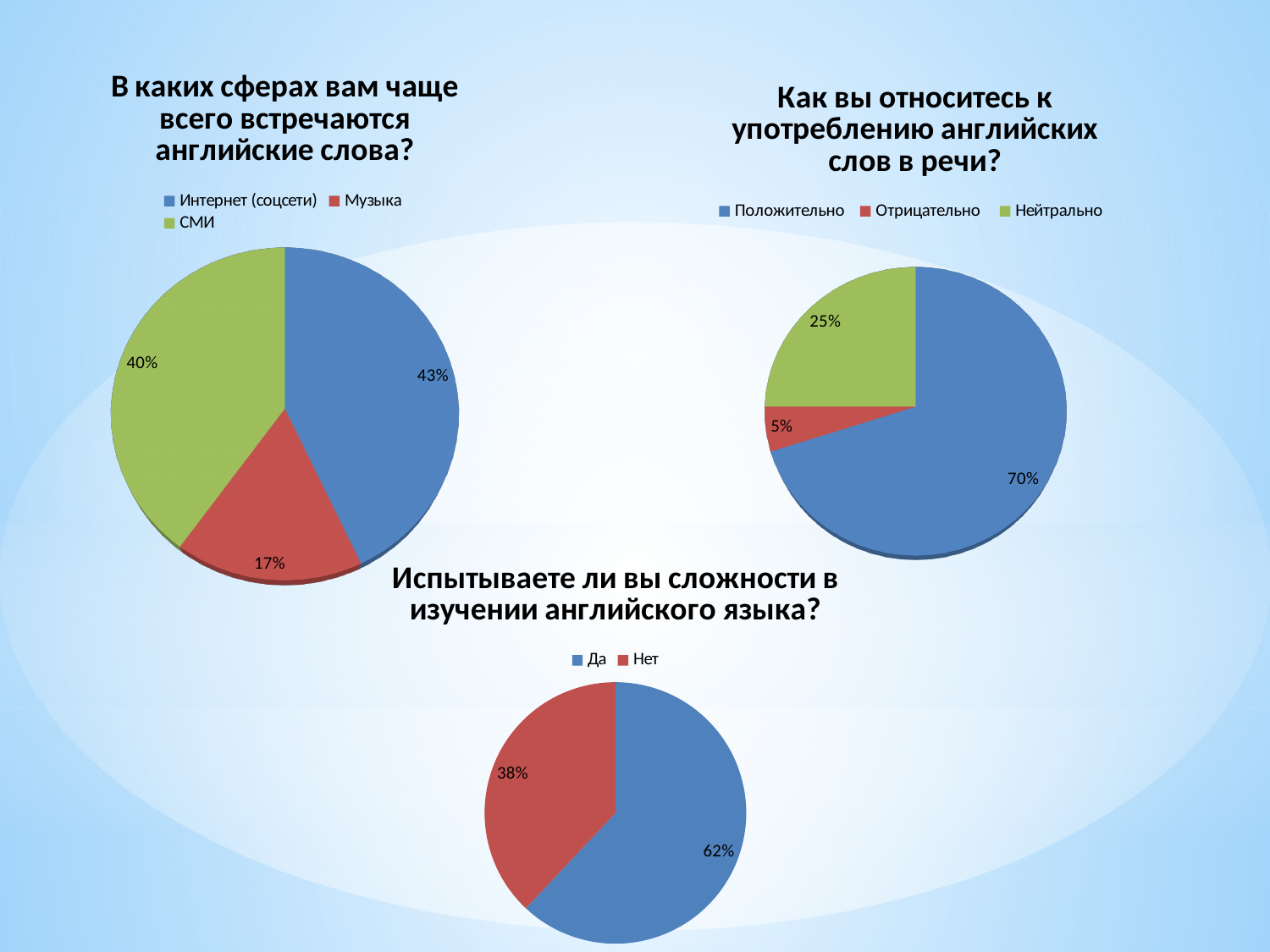
In the chart titled "Испытываете ли вы сложности в изучении английского языка?", what share does "Да" have? 62% In the chart titled "В каких сферах вам чаще всего встречаются английские слова?", what share does "Интернет (соцсети)" have? 43% In the chart titled "Как вы относитесь к употреблению английских слов в речи?", how many categories does the legend list? 3 In the chart titled "Испытываете ли вы сложности в изучении английского языка?", which is larger, "Да" or "Нет"? Да In the chart titled "Испытываете ли вы сложности в изучении английского языка?", what is the difference between the shares of "Да" and "Нет"? 24% In the chart titled "В каких сферах вам чаще всего встречаются английские слова?", what is the difference between the shares of "Интернет (соцсети)" and "СМИ"? 3% In the chart titled "Как вы относитесь к употреблению английских слов в речи?", which category has the largest share? Положительно What type of chart is used for "Испытываете ли вы сложности в изучении английского языка?"? Pie chart In the chart titled "В каких сферах вам чаще всего встречаются английские слова?", what share does "Музыка" have? 17% In the chart titled "В каких сферах вам чаще всего встречаются английские слова?", which category has the smallest share? Музыка In the chart titled "Как вы относитесь к употреблению английских слов в речи?", what share does "Положительно" have? 70% In the chart titled "Как вы относитесь к употреблению английских слов в речи?", what share does "Отрицательно" have? 5%